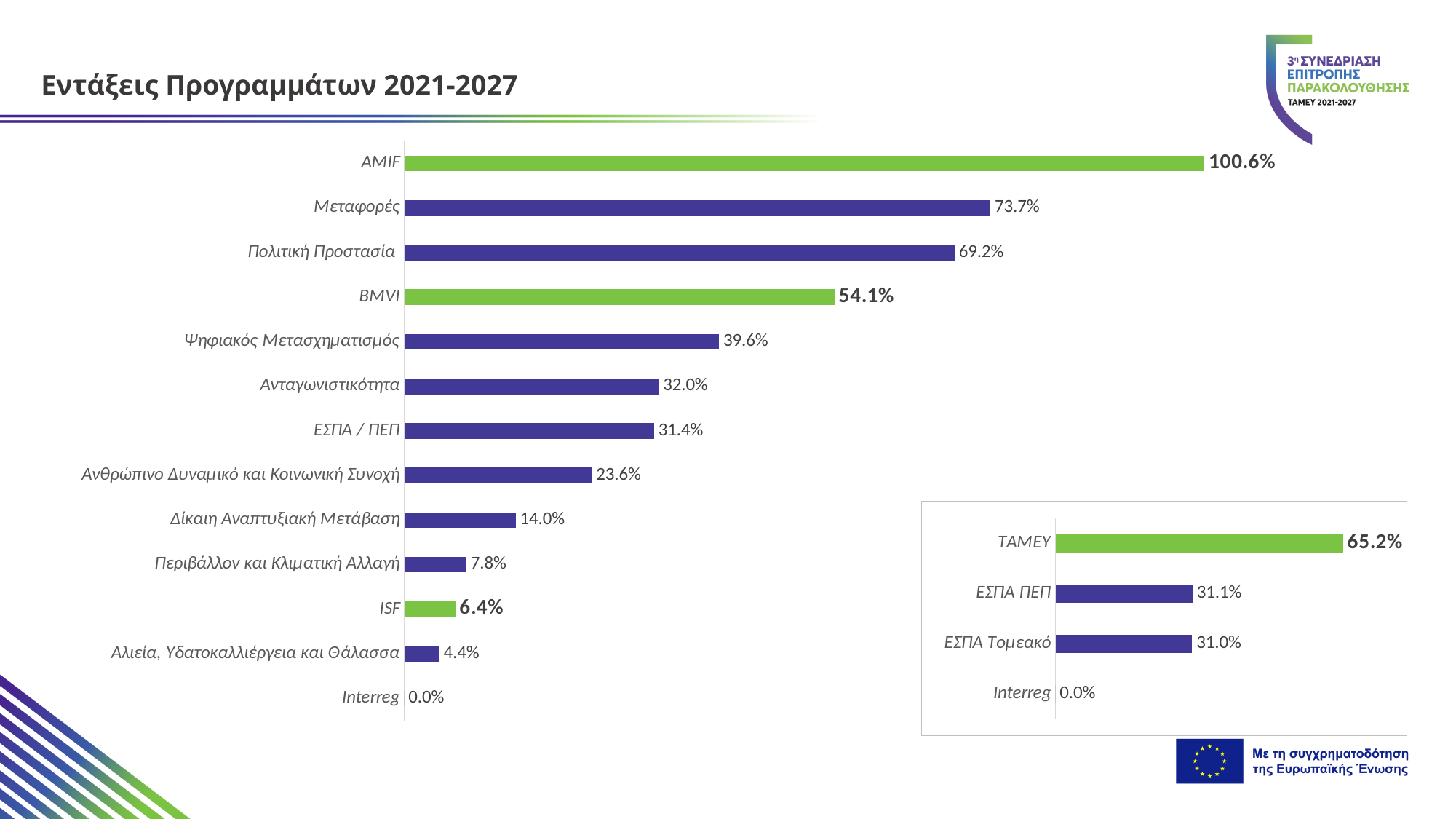
In the large chart on the left, which category has the highest value? AMIF How many categories are shown in the large chart on the left? 13 In the large chart on the left, which category has the lowest value? Interreg What kind of chart is the large chart on the left? Bar chart In the small chart on the right, what is the difference between the values for ΕΣΠΑ ΠΕΠ and ΕΣΠΑ Τομεακό? 0.1% In the large chart on the left, what is the value for AMIF? 100.6% In the large chart on the left, what is the difference between the values for Μεταφορές and Πολιτική Προστασία? 4.5% How many categories are shown in the small chart on the right? 4 In the small chart on the right, what is the value for ΤΑΜΕΥ? 65.2% In the large chart on the left, which is larger: the value for BMVI or the value for Ανταγωνιστικότητα? BMVI In the large chart on the left, what is the value for Ψηφιακός Μετασχηματισμός? 39.6% In the small chart on the right, which category has the highest value? ΤΑΜΕΥ